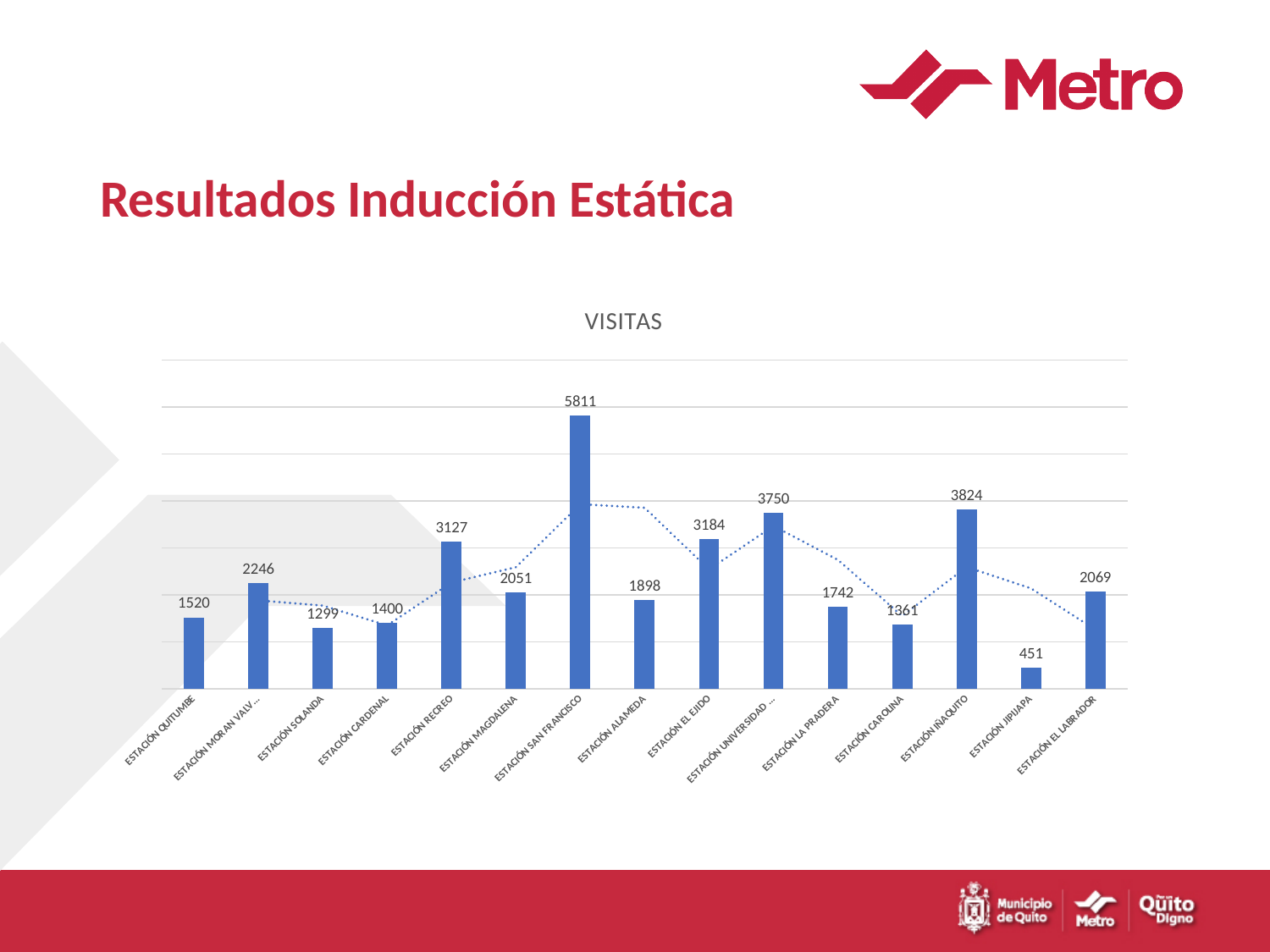
Which has a larger value in the VISITAS chart, ESTACIÓN QUITUMBE or ESTACIÓN CARDENAL? ESTACIÓN QUITUMBE What kind of chart is the VISITAS chart? Bar chart What is the value for ESTACIÓN JIPIJAPA in the VISITAS chart? 451 How many stations are shown in the VISITAS chart? 15 Which has a larger value in the VISITAS chart, ESTACIÓN UNIVERSIDAD or ESTACIÓN EL EJIDO? ESTACIÓN UNIVERSIDAD What is the value for ESTACIÓN IÑAQUITO in the VISITAS chart? 3824 What is the difference between the values for ESTACIÓN EL EJIDO and ESTACIÓN RECREO in the VISITAS chart? 57 What is the value for ESTACIÓN EL LABRADOR in the VISITAS chart? 2069 What is the difference between the values for ESTACIÓN SAN FRANCISCO and ESTACIÓN IÑAQUITO in the VISITAS chart? 1987 Which station has the highest value in the VISITAS chart? ESTACIÓN SAN FRANCISCO What is the value for ESTACIÓN SAN FRANCISCO in the VISITAS chart? 5811 Which station has the lowest value in the VISITAS chart? ESTACIÓN JIPIJAPA